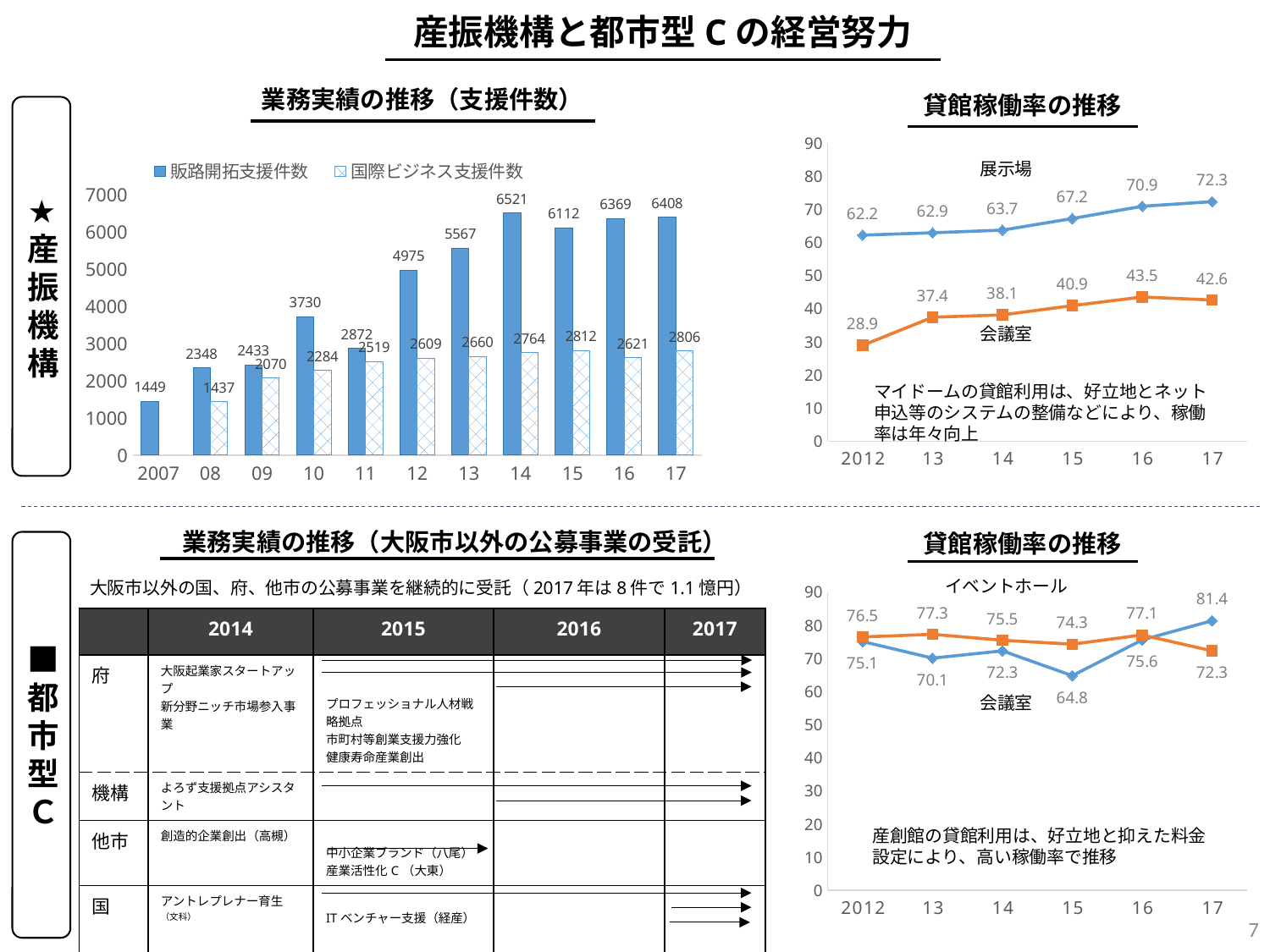
In the bottom-right line chart 貸館稼働率の推移, how many years are plotted on the x axis? 6 In the top-right line chart 貸館稼働率の推移, which year has the lowest 会議室 value? 2012 In the bottom-right line chart 貸館稼働率の推移, which is larger in 2015, イベントホール or 会議室? 会議室 In the top-left bar chart 業務実績の推移（支援件数）, which year has the highest 販路開拓支援件数? 2014 In the top-left bar chart 業務実績の推移（支援件数）, what is the difference between 販路開拓支援件数 and 国際ビジネス支援件数 in 2017? 3602 What kind of chart is the top-left chart 業務実績の推移（支援件数）? Bar chart In the top-left bar chart 業務実績の推移（支援件数）, what is the value of 販路開拓支援件数 for 2014? 6521 In the bottom-right line chart 貸館稼働率の推移, what is the value of イベントホール for 2017? 81.4 In the top-right line chart 貸館稼働率の推移, what is the value of 会議室 for 2012? 28.9 In the top-left bar chart 業務実績の推移（支援件数）, what is the value of 国際ビジネス支援件数 for 2017? 2806 In the top-right line chart 貸館稼働率の推移, what is the value of 展示場 for 2016? 70.9 In the top-left bar chart 業務実績の推移（支援件数）, how many series does the legend list? 2